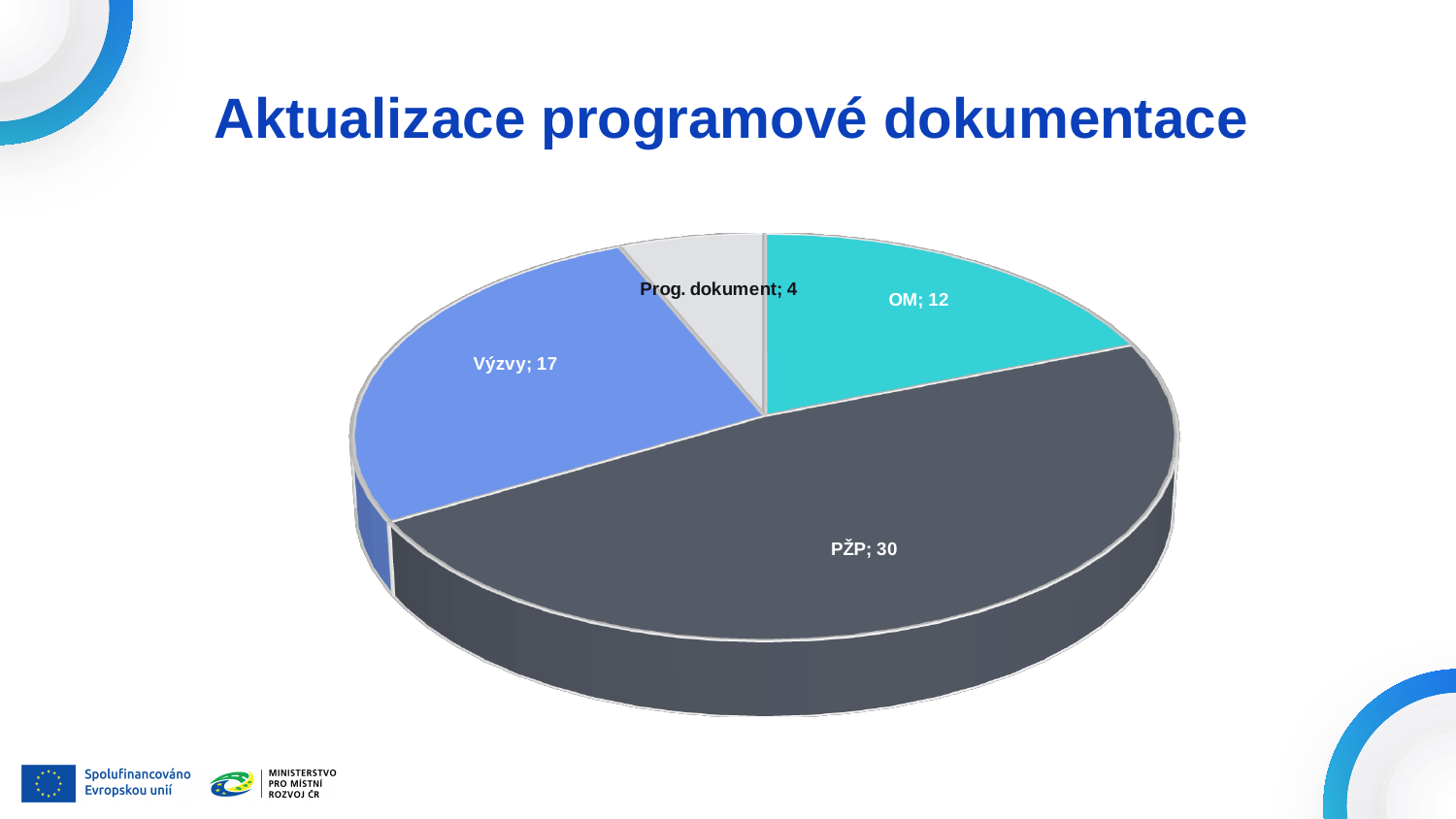
Which category has the smallest slice? Prog. dokument What is the value for Prog. dokument? 4 What is the title of the slide containing the chart? Aktualizace programové dokumentace What is the value for PŽP? 30 Which is larger, the value for OM or the value for Výzvy? Výzvy Which category has the largest slice? PŽP What kind of chart is shown on the slide? pie chart What is the difference between the values for PŽP and Výzvy? 13 How many slices does the pie chart have? 4 What is the value for OM? 12 What is the value for Výzvy? 17 What is the total of all slices in the pie chart? 63